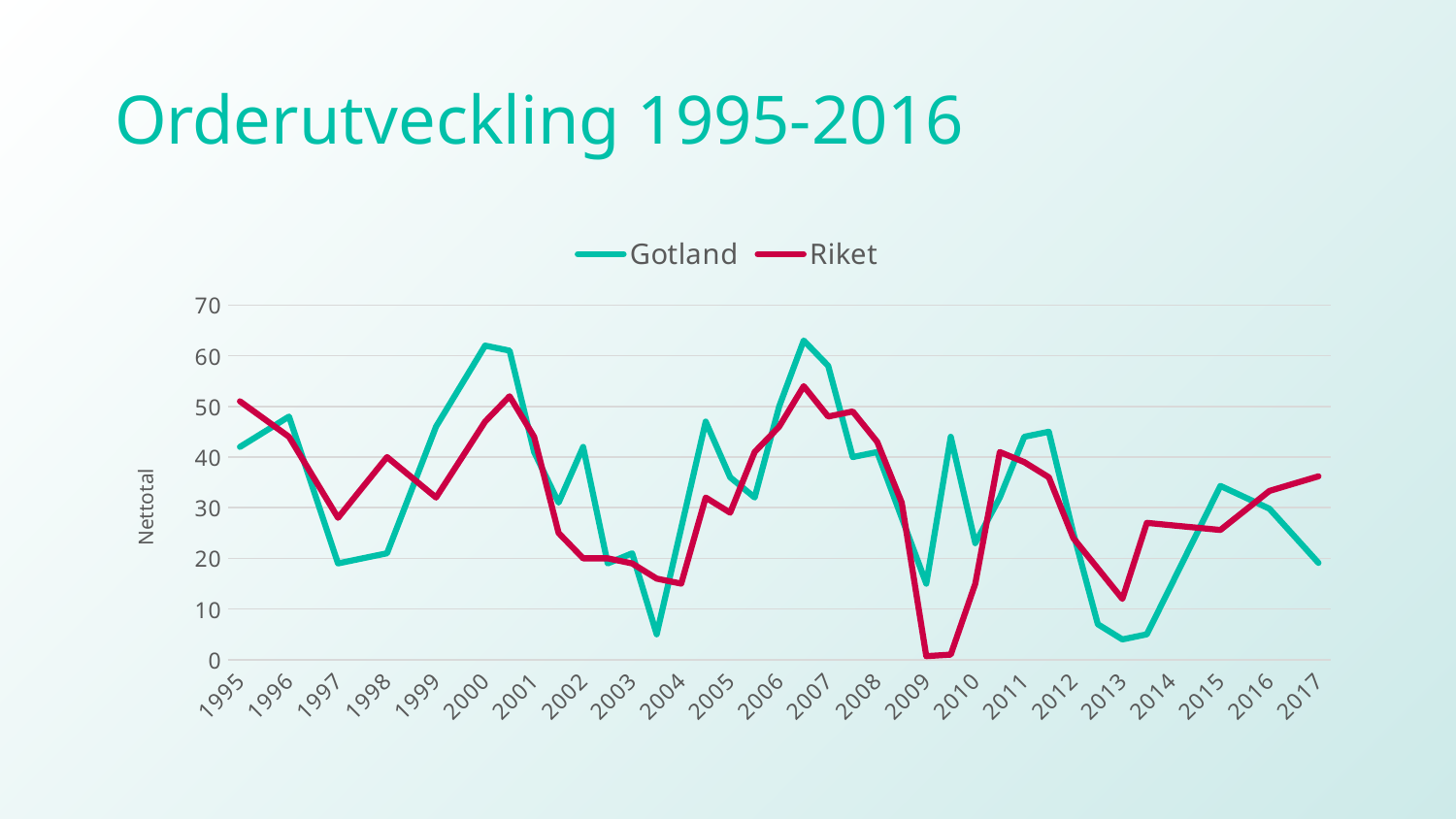
What kind of chart is shown on the slide? line chart Is the value for Gotland at 2017 greater or less than 30? less At 2017, which series has the higher value, Gotland or Riket? Riket In which year does the Riket series reach its lowest value? 2009 Is the value for Riket at 1995 greater or less than 40? greater What is the label on the vertical axis? Nettotal Is the value for Gotland at 2000 greater or less than 50? greater How many series does the legend list? 2 At 2000, which series has the higher value, Gotland or Riket? Gotland How many year labels are shown on the x axis? 23 What is the title of the chart? Orderutveckling 1995-2016